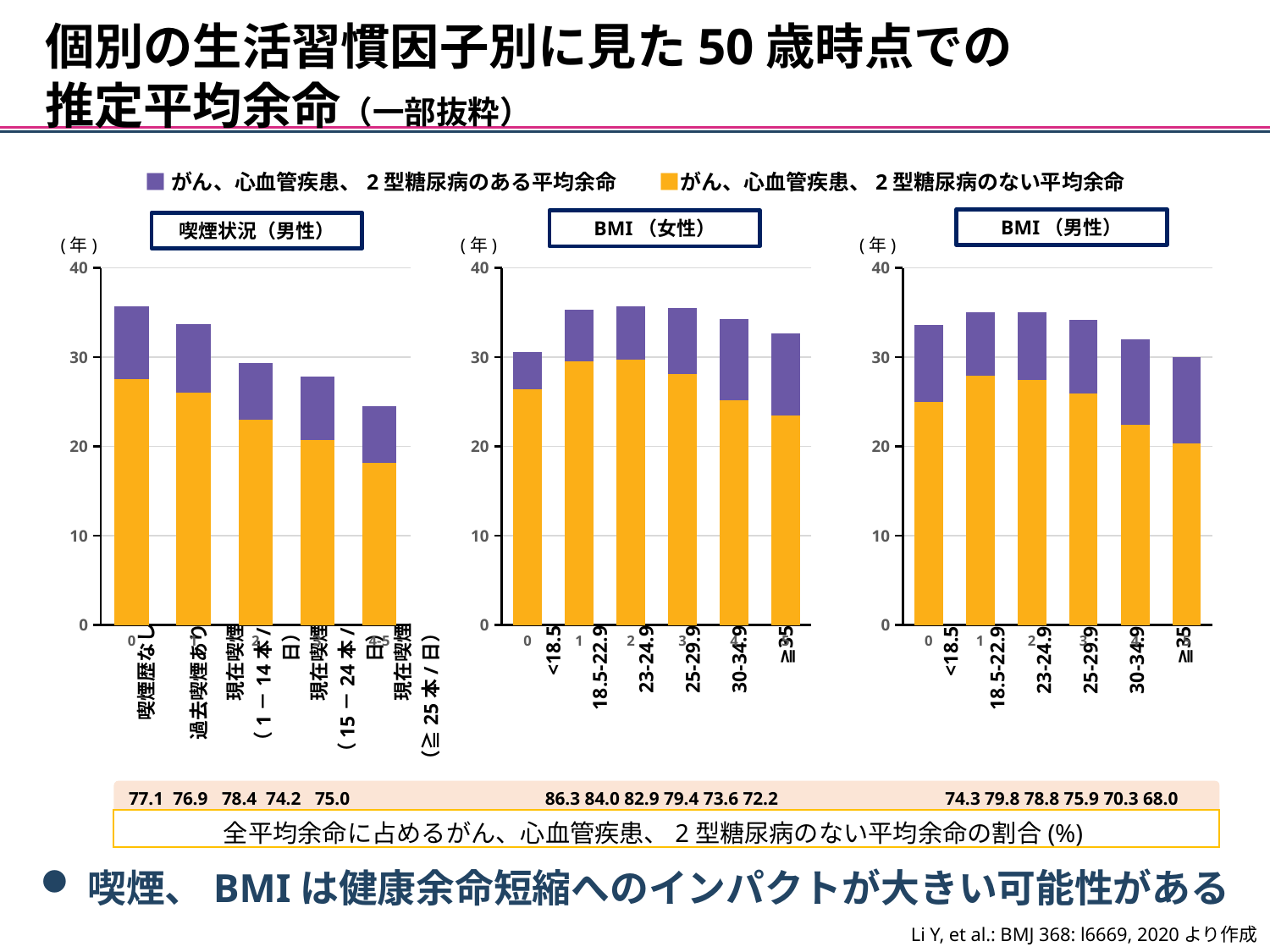
In the 喫煙状況（男性） chart, which category has the highest total bar? 喫煙歴なし In the 喫煙状況（男性） chart, do the total bars rise or fall from left to right along the x axis? fall In the 喫煙状況（男性） chart, is the total bar for 現在喫煙（≧25本/日） greater or less than 30? less How many series does the legend list? 2 In the 喫煙状況（男性） chart, which category has the lowest total bar? 現在喫煙（≧25本/日） How many categories are shown on the x axis of the 喫煙状況（男性） chart? 5 How many categories are shown on the x axis of the BMI（女性） chart? 6 According to the percentages printed below the charts, what share of total life expectancy is free of cancer, cardiovascular disease and type 2 diabetes for BMI <18.5 in the BMI（女性） chart? 86.3 In the BMI（男性） chart, is the orange (がん、心血管疾患、2型糖尿病のない平均余命) value for 30-34.9 greater or less than 25? less According to the percentages printed below the charts, what is the difference between the share for BMI <18.5 and BMI ≥35 in the BMI（女性） chart? 14.1 What kind of chart is the 喫煙状況（男性） chart? stacked bar chart In the BMI（男性） chart, which BMI category has the lowest total bar? ≥35